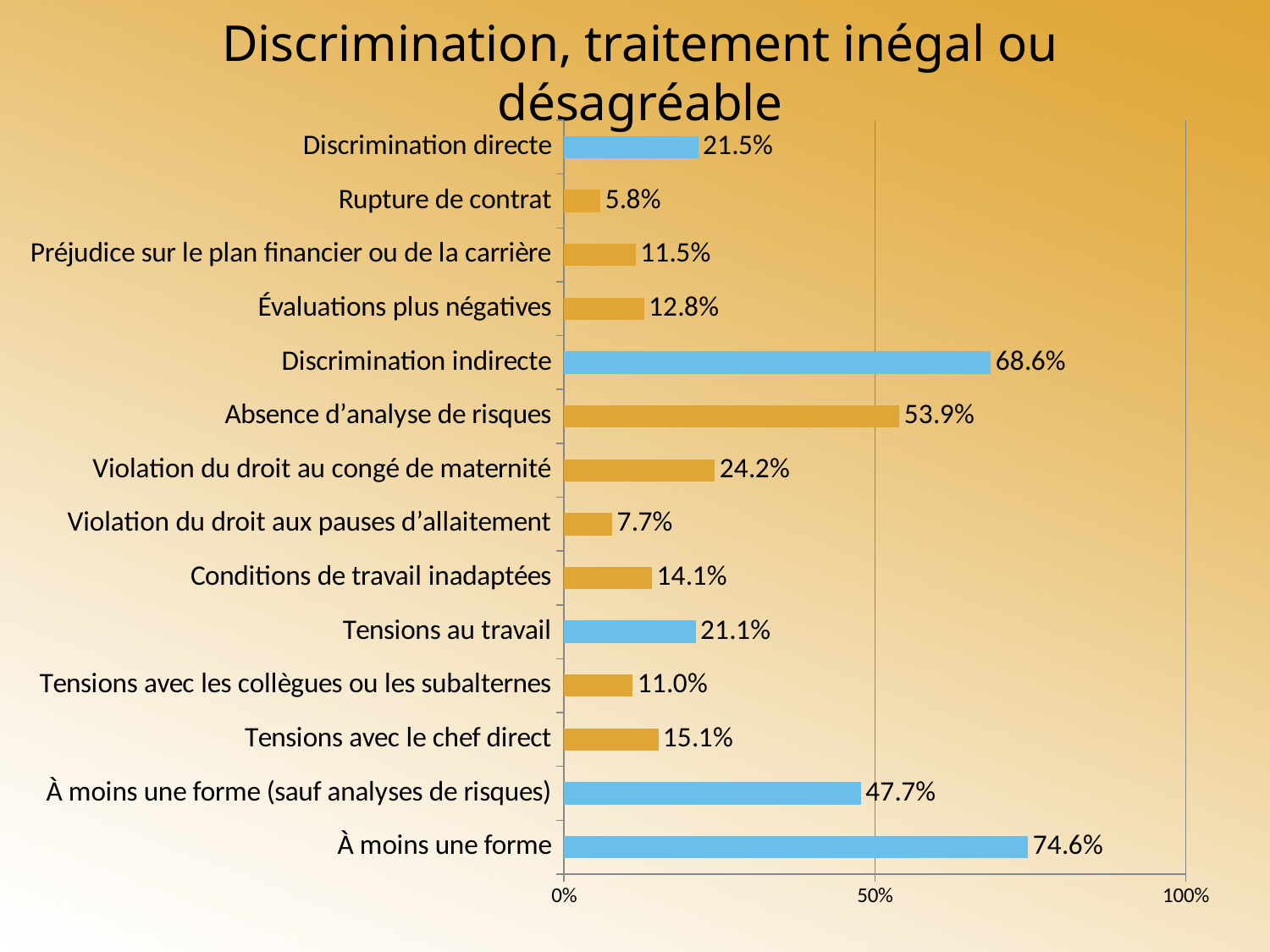
How many categories are shown in the chart? 14 What kind of chart is shown on the slide? bar chart Which is larger, Discrimination directe or Discrimination indirecte? Discrimination indirecte What is the difference between À moins une forme and À moins une forme (sauf analyses de risques)? 26.9% What is the difference between Évaluations plus négatives and Préjudice sur le plan financier ou de la carrière? 1.3% What is the title of the chart? Discrimination, traitement inégal ou désagréable What is the value for Tensions avec le chef direct? 15.1% Is the value for Absence d'analyse de risques greater or less than 50%? greater What is the value for Violation du droit au congé de maternité? 24.2% Which category has the lowest value? Rupture de contrat What is the value for Discrimination indirecte? 68.6% Which category has the highest value? À moins une forme